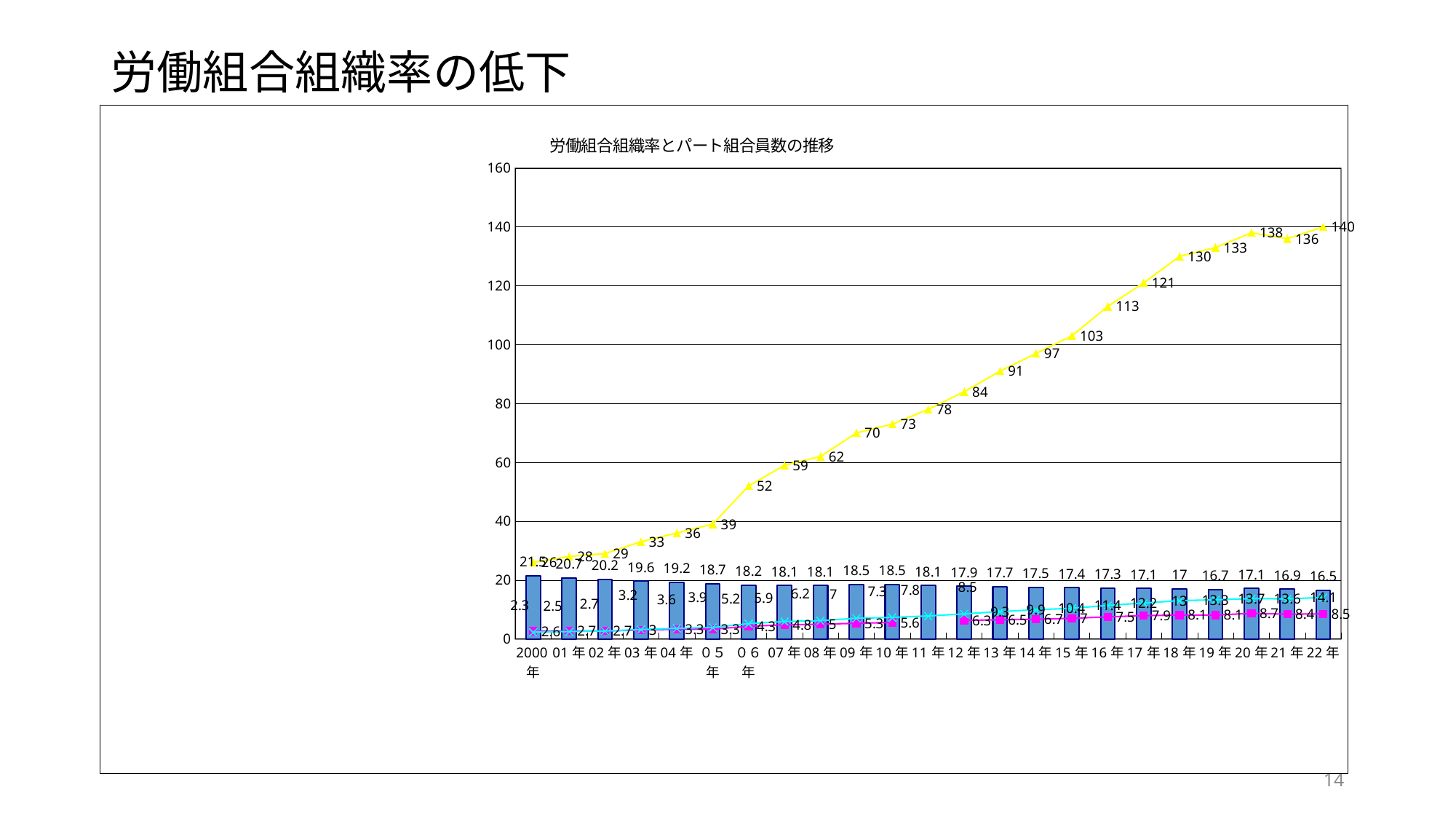
What is the difference between the yellow line values for 22年 and 2000年? 114 What is the value of the yellow triangle line for 15年? 103 What is the value of the yellow triangle line for 22年? 140 In which year is the blue bar the lowest? 22年 In which year does the yellow triangle line reach its highest value? 22年 What kind of chart is shown on the slide? Combined bar and line chart What is the title of the chart? 労働組合組織率とパート組合員数の推移 What is the value of the blue bar for 22年? 16.5 How many years (categories) are plotted along the x axis? 23 What is the value of the blue bar for 2000年? 21.5 Do the blue bars generally rise or fall from 2000年 to 22年? Fall Which is larger, the blue bar for 2000年 or the blue bar for 22年? 2000年